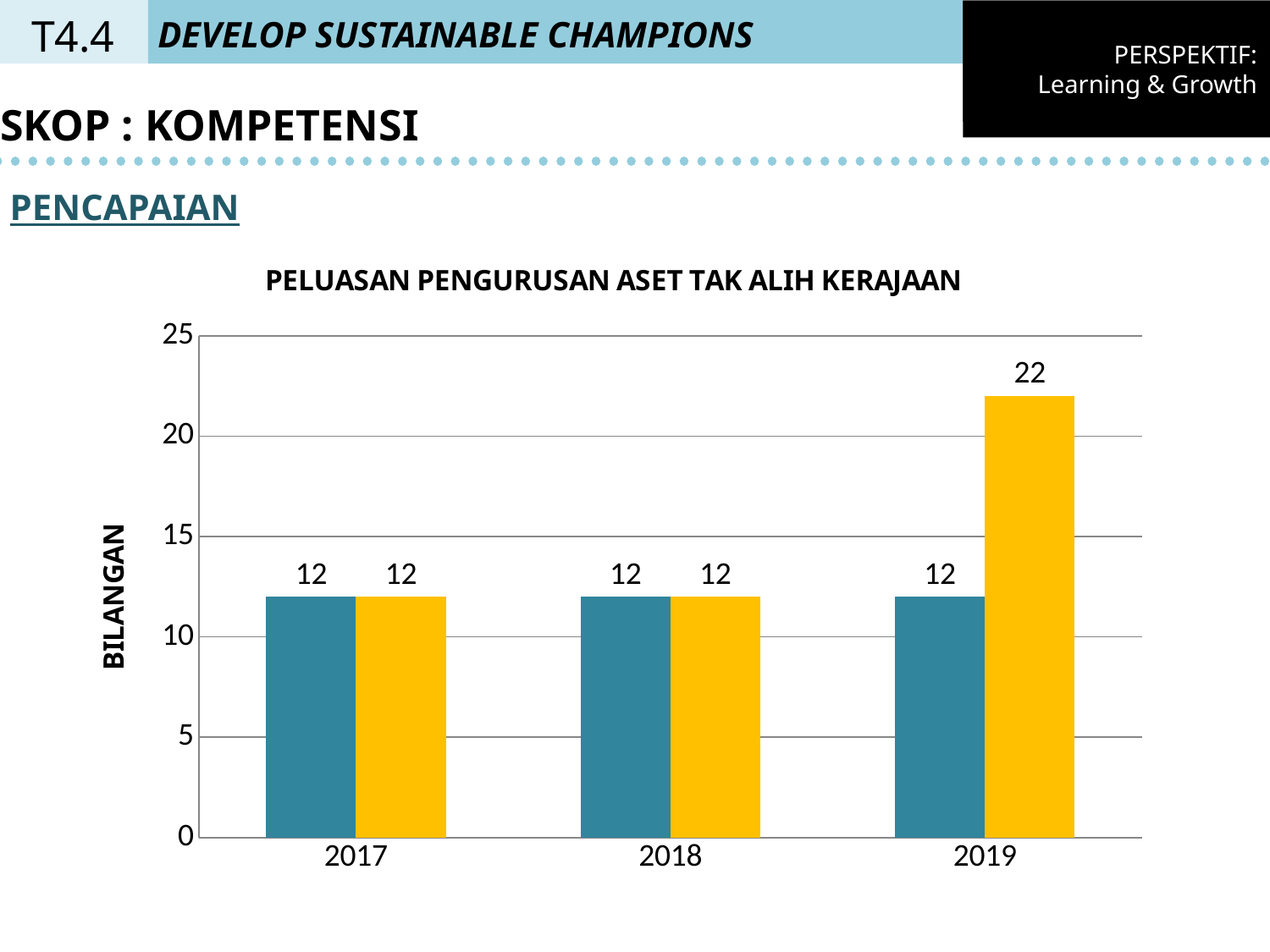
Is the value of the yellow bar for 2019 greater or less than 20? greater What is the value of the blue bar for 2018? 12 In 2019, which bar is larger, the blue bar or the yellow bar? the yellow bar What is the difference between the yellow bar and the blue bar in 2019? 10 How many years are shown on the x axis? 3 In which year is the yellow bar highest? 2019 What is the label on the y axis of the chart? BILANGAN What is the value of the yellow bar for 2017? 12 What is the title of the chart? PELUASAN PENGURUSAN ASET TAK ALIH KERAJAAN What is the value of the yellow bar for 2019? 22 What is the value of the blue bar for 2019? 12 What kind of chart is shown on the slide? bar chart